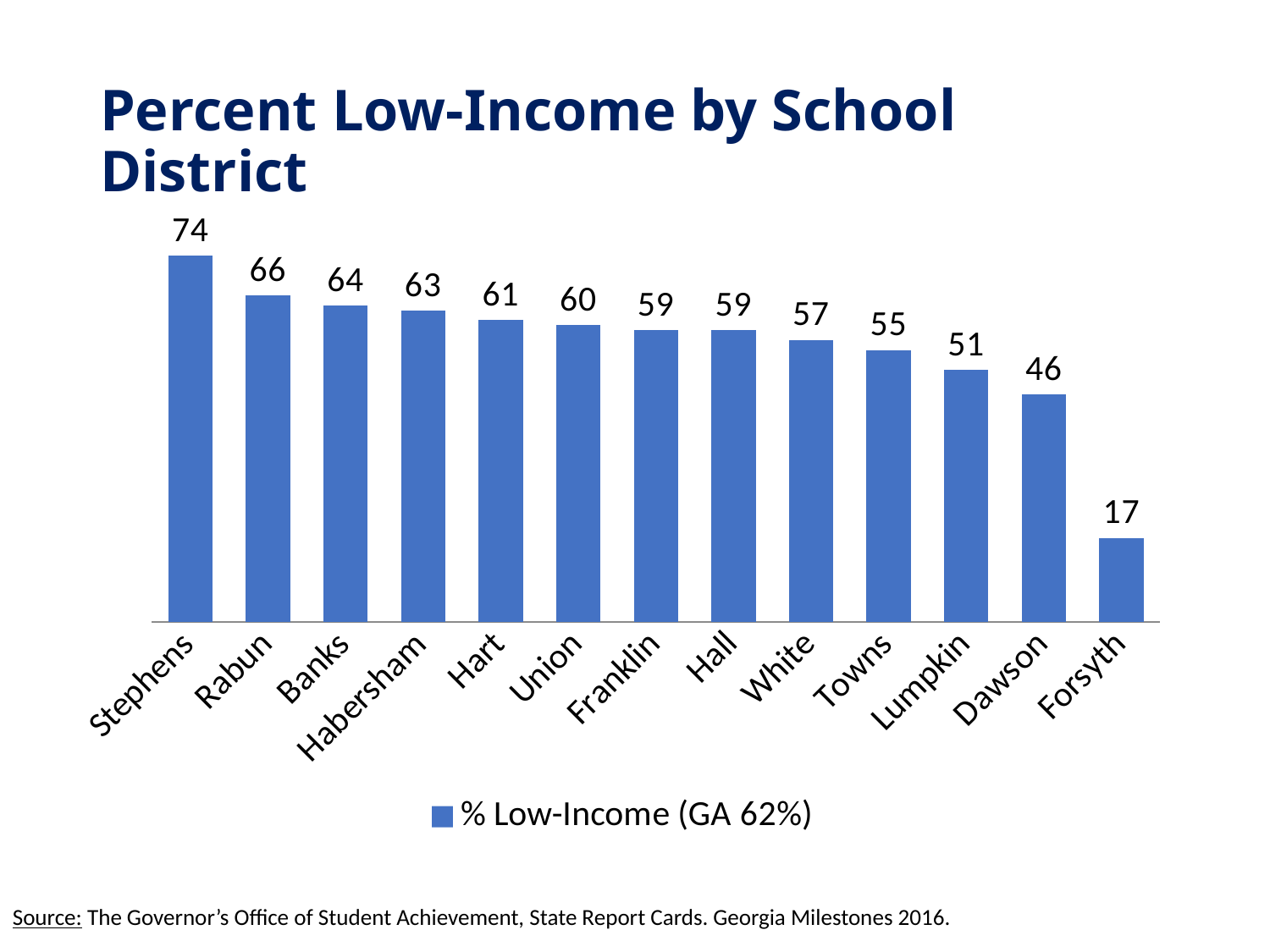
Which school district has the highest percent low-income? Stephens What kind of chart is shown on the slide? Bar chart How many school districts are shown in the chart? 13 What is the percent low-income value for Habersham? 63 What is the legend entry for the series in the chart? % Low-Income (GA 62%) How many series does the legend list? 1 What is the difference between the values for Stephens and Forsyth? 57 Which has a higher percent low-income, Lumpkin or Towns? Towns What is the difference between the values for Rabun and Dawson? 20 What is the percent low-income value for Forsyth? 17 Which school district has the lowest percent low-income? Forsyth What is the percent low-income value for Stephens? 74